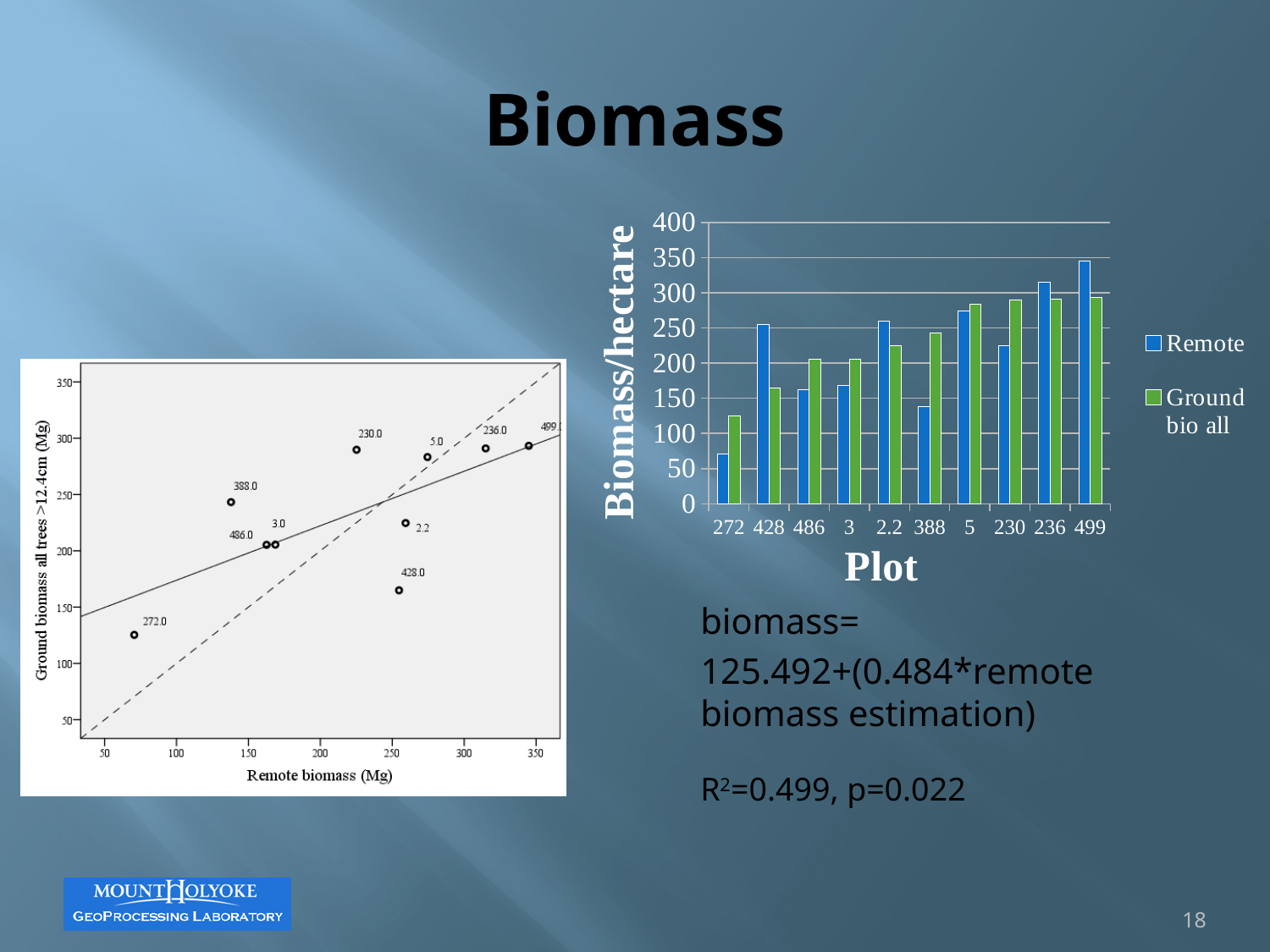
In the bar chart on the right, for plot 428, which is larger: Remote or Ground bio all? Remote In the bar chart on the right, for plot 388, which is larger: Remote or Ground bio all? Ground bio all In the bar chart on the right, which plot has the lowest Ground bio all value? 272 What kind of chart is the chart on the right of the slide (Biomass/hectare by Plot)? bar chart In the bar chart on the right, how many plots are shown on the x axis? 10 In the bar chart on the right, which plot has the lowest Remote value? 272 In the scatter plot on the left, which plot has the lowest remote biomass? 272.0 In the bar chart on the right, is the Ground bio all value for plot 272 greater or less than 150? less In the bar chart on the right, which plot has the highest Remote value? 499 In the bar chart on the right, is the Remote value for plot 499 greater or less than 300? greater In the bar chart on the right, what are the two legend entries? Remote, Ground bio all In the bar chart on the right, how many series does the legend list? 2